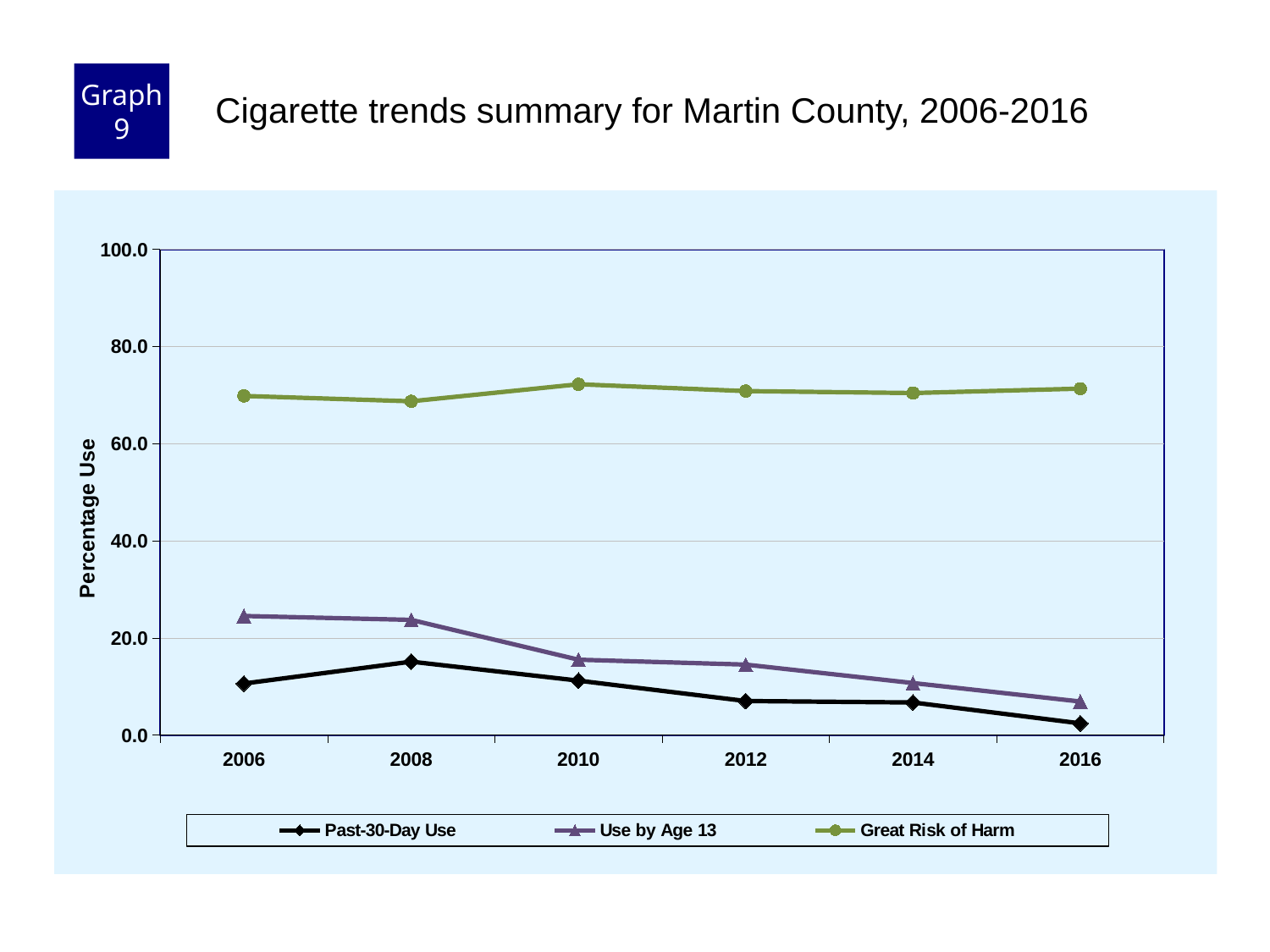
Is the value for Use by Age 13 in 2006 greater or less than 20.0? greater In which year is Past-30-Day Use lowest? 2016 In which year is Past-30-Day Use highest? 2008 How many years are plotted along the x axis? 6 Is the value for Great Risk of Harm in 2010 greater or less than 80.0? less In 2006, which is larger: Use by Age 13 or Past-30-Day Use? Use by Age 13 What is the label on the y axis? Percentage Use In which year is Use by Age 13 lowest? 2016 How many series does the legend list? 3 What kind of chart is shown on the slide? line chart Is the value for Past-30-Day Use in 2012 greater or less than 20.0? less Does the Use by Age 13 series rise or fall from 2006 to 2016? fall